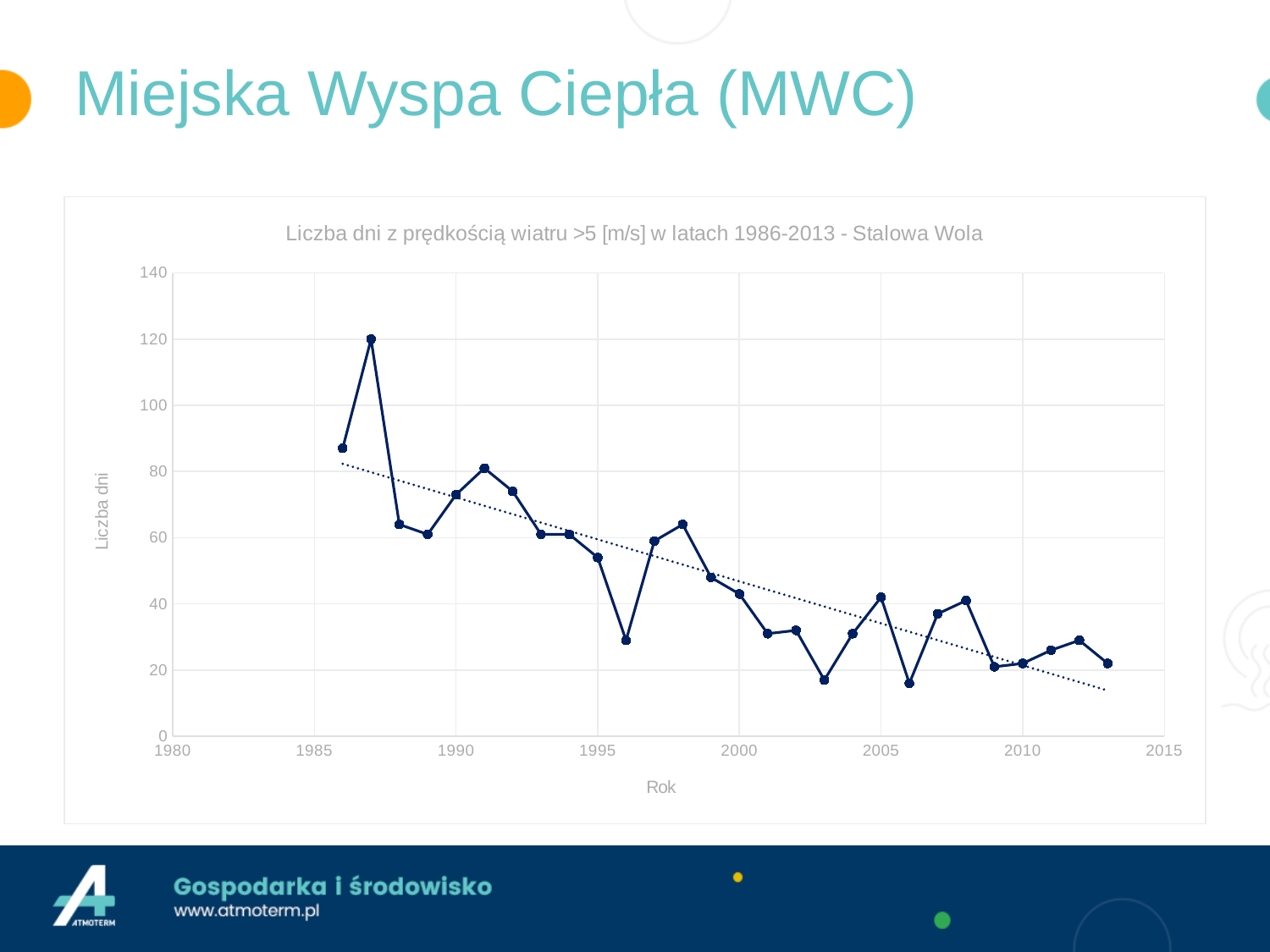
What is the title of the chart? Liczba dni z prędkością wiatru >5 [m/s] w latach 1986-2013 - Stalowa Wola Is the value for 2003 greater or less than 20? less Is the value for 2013 greater or less than 40? less What is the label of the x axis? Rok Is the value for 1987 greater or less than 100? greater What kind of chart is shown on the slide? line chart Which year has the highest number of days? 1987 Which year has the larger value, 1991 or 1998? 1991 Do the values generally rise or fall from 1986 to 2013? fall Which year has the larger value, 2005 or 2006? 2005